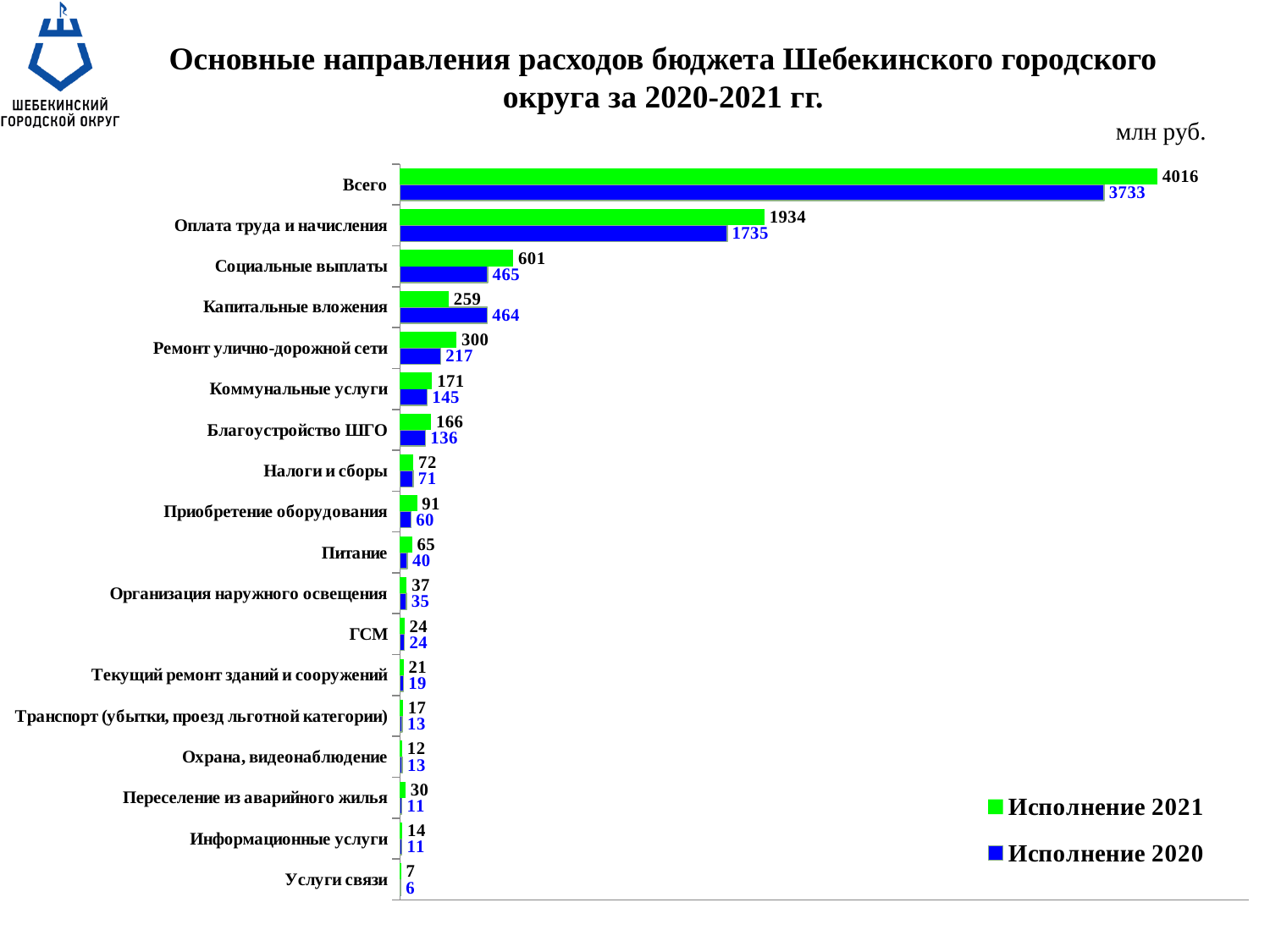
What is the value for Исполнение 2020 for Капитальные вложения? 464 How many series does the legend list? 2 What is the value for Исполнение 2021 for Переселение из аварийного жилья? 30 What is the value for Исполнение 2021 for Оплата труда и начисления? 1934 What is the difference between Исполнение 2021 and Исполнение 2020 for Ремонт улично-дорожной сети? 83 Excluding Всего, which category has the highest value for Исполнение 2021? Оплата труда и начисления Which category has the lowest value for Исполнение 2020? Услуги связи What is the value for Исполнение 2020 for Социальные выплаты? 465 For Капитальные вложения, which is larger: Исполнение 2021 or Исполнение 2020? Исполнение 2020 What kind of chart is shown on the slide? Bar chart What is the difference between Исполнение 2021 and Исполнение 2020 for Всего? 283 How many categories are shown on the chart? 18